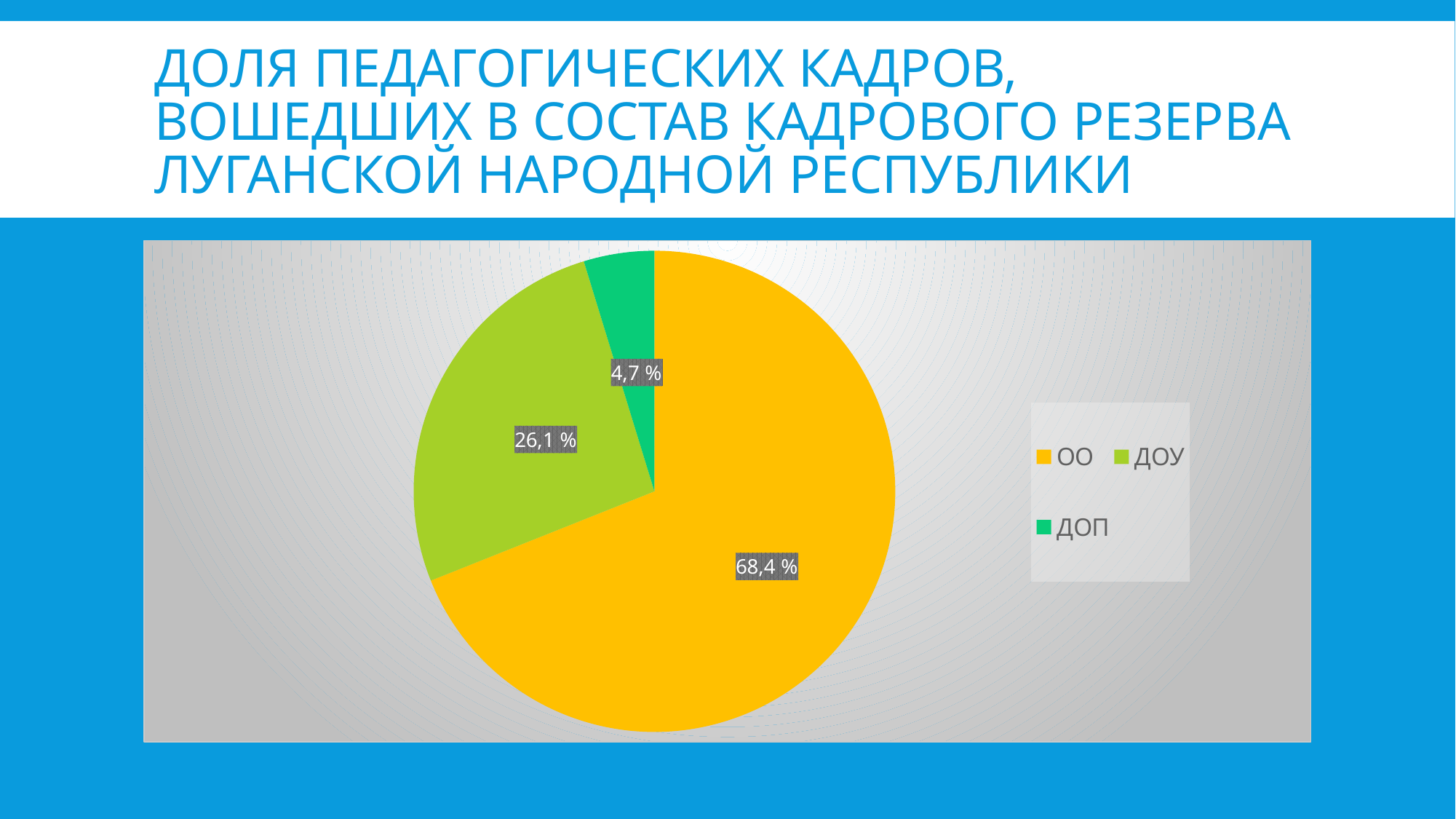
What is the value for ДОУ? 26,1 % What kind of chart is shown on the slide? pie chart What is the difference between the share for ОО and the share for ДОУ? 42,3 % What is the value for ДОП? 4,7 % Which category has the smallest share of the pie? ДОП What is the difference between the share for ДОУ and the share for ДОП? 21,4 % Which category has the largest share of the pie? ОО How many slices does the pie chart have? 3 Which is larger, the share for ДОУ or the share for ДОП? ДОУ How many entries does the legend list? 3 What is the value for ОО? 68,4 % What colour is the slice for ДОУ? green